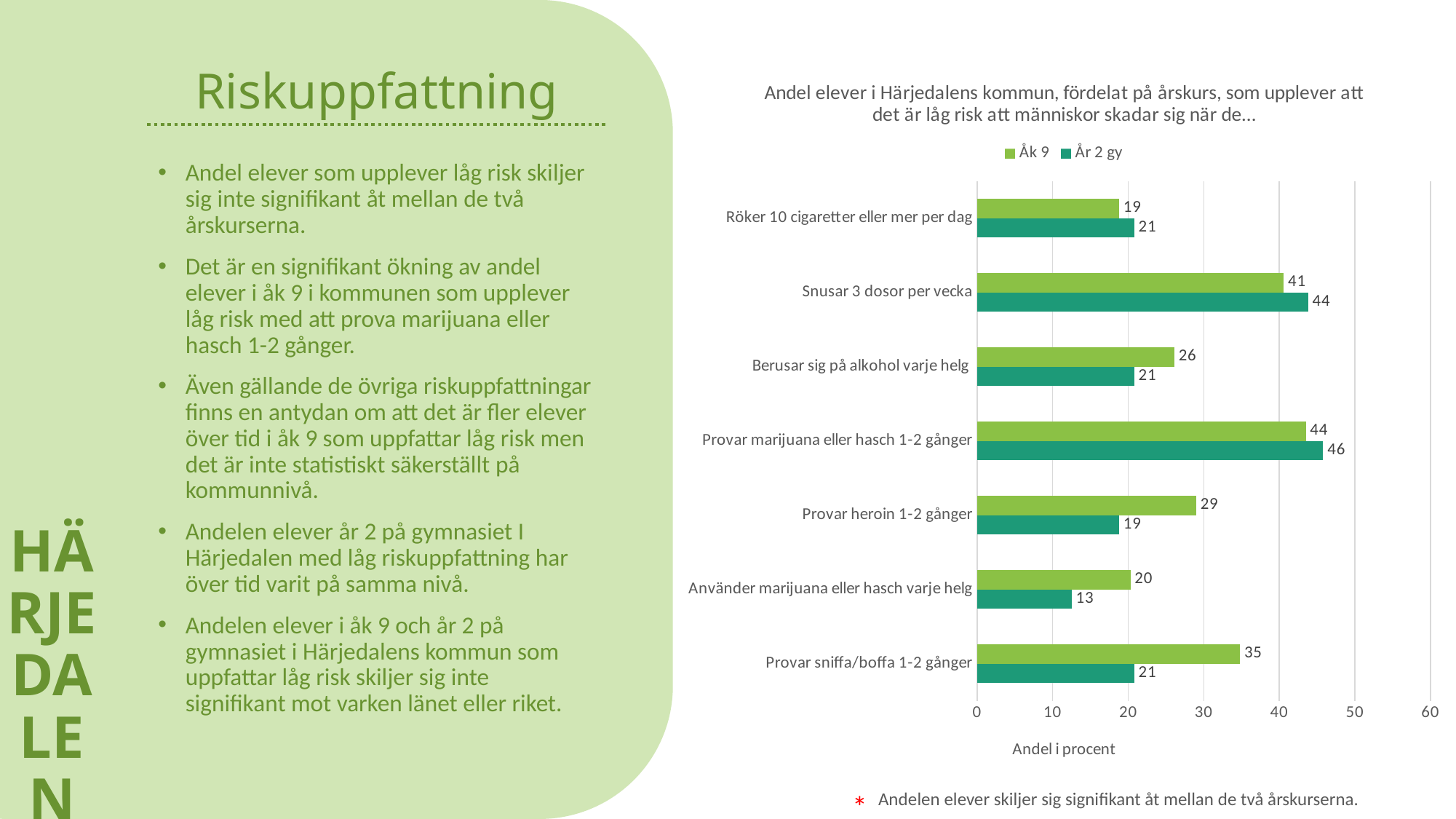
Which category has the highest value for Åk 9? Provar marijuana eller hasch 1-2 gånger Which category has the lowest value for År 2 gy? Använder marijuana eller hasch varje helg How many series does the legend list? 2 How many categories are shown on the chart? 7 What kind of chart is shown on the slide? Bar chart What is the difference between the Åk 9 and År 2 gy values for 'Provar sniffa/boffa 1-2 gånger'? 14 What is the value for År 2 gy for 'Använder marijuana eller hasch varje helg'? 13 What is the label of the horizontal axis of the chart? Andel i procent What is the value for Åk 9 for 'Provar heroin 1-2 gånger'? 29 Which is larger for 'Berusar sig på alkohol varje helg': the Åk 9 value or the År 2 gy value? Åk 9 What is the value for År 2 gy for 'Snusar 3 dosor per vecka'? 44 Is the Åk 9 value for 'Snusar 3 dosor per vecka' greater or less than 30? greater